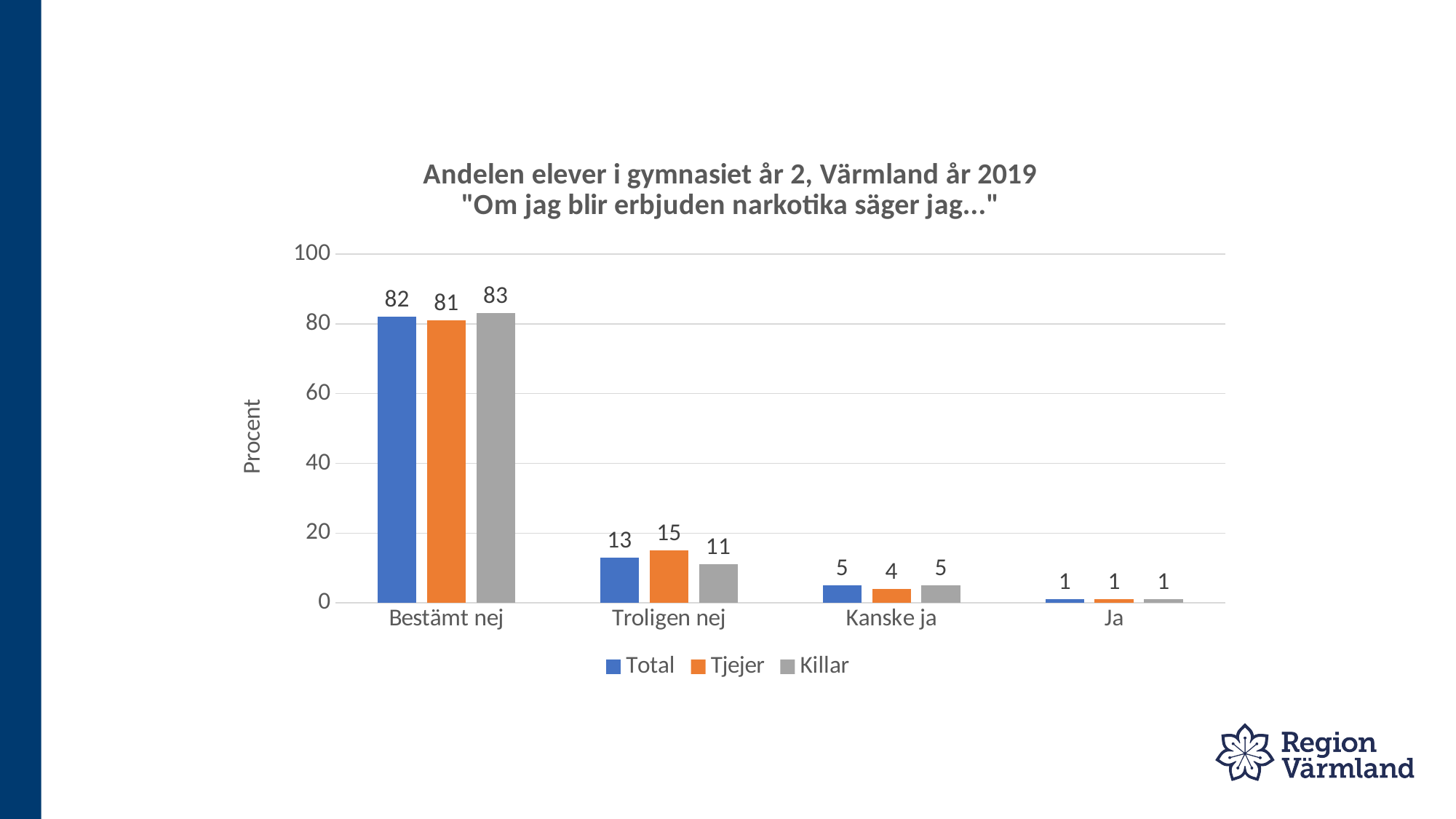
What is the difference between the Killar and Tjejer values in the "Bestämt nej" category? 2 Which category has the lowest value for the Tjejer series? Ja Is the value for Total in "Bestämt nej" greater or less than 80? greater What is the value for Tjejer in the "Troligen nej" category? 15 What is the value for Total in the "Bestämt nej" category? 82 How many series does the legend list? 3 What is the value for Killar in the "Kanske ja" category? 5 Which category has the highest value for the Total series? Bestämt nej What is the label of the y axis? Procent In the "Troligen nej" category, which is larger: Tjejer or Killar? Tjejer What kind of chart is shown on the slide? bar chart How many categories are shown on the x axis? 4